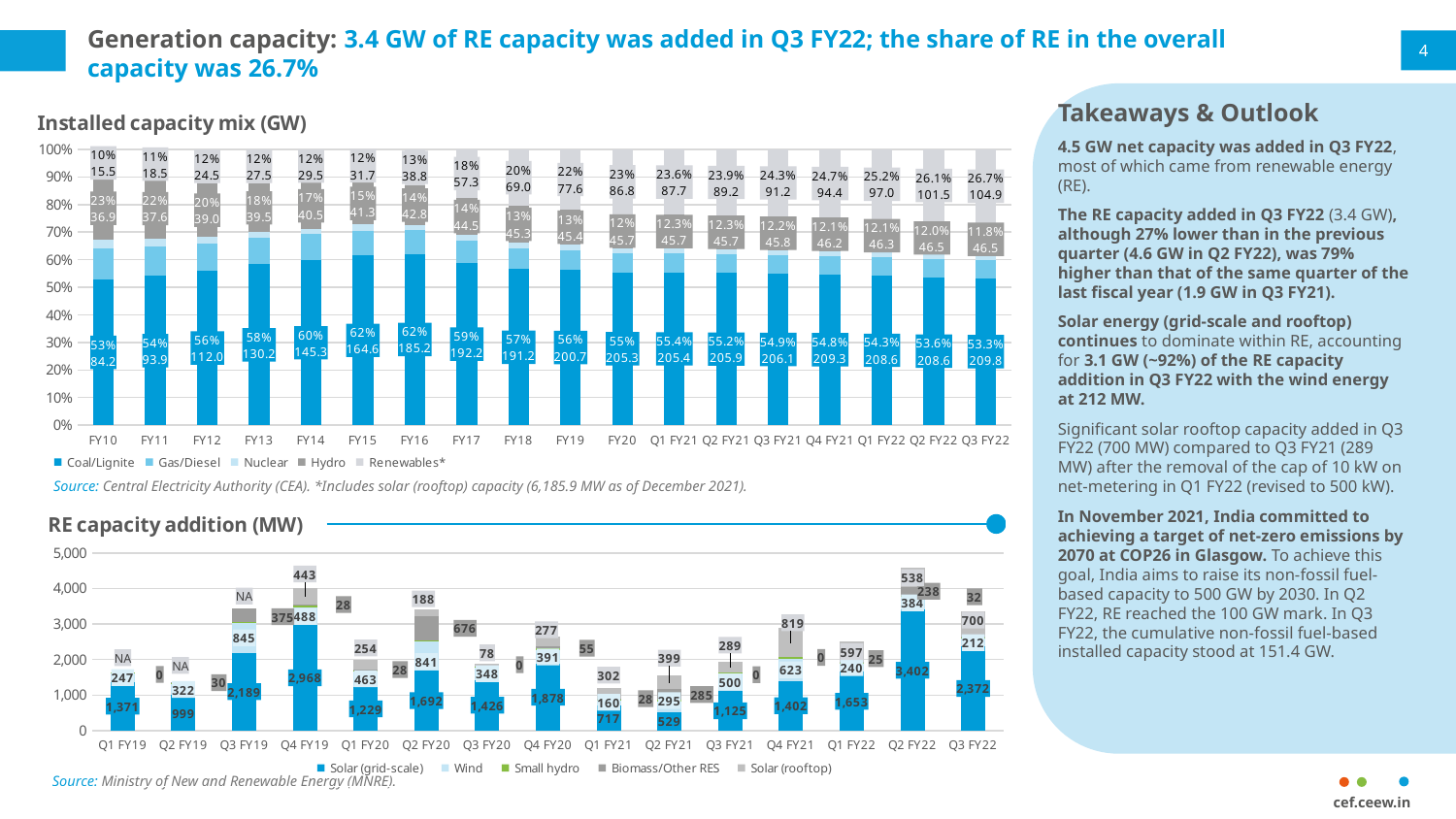
In the 'Installed capacity mix (GW)' chart, how many series does the legend list? 5 In the 'RE capacity addition (MW)' chart, what is the Solar (grid-scale) capacity added in Q2 FY22? 3,402 In the 'RE capacity addition (MW)' chart, what is the difference between the Solar (grid-scale) additions in Q2 FY22 and Q3 FY22? 1,030 In the 'RE capacity addition (MW)' chart, what is the Solar (rooftop) capacity added in Q3 FY22? 700 In the 'Installed capacity mix (GW)' chart, what is the Coal/Lignite capacity in GW for FY16? 185.2 In the 'RE capacity addition (MW)' chart, how many quarters are shown on the x axis? 15 In the 'Installed capacity mix (GW)' chart, what is the Renewables share of installed capacity in Q3 FY22? 26.7% What type of chart is the 'RE capacity addition (MW)' chart? stacked bar chart In the 'Installed capacity mix (GW)' chart, which is larger: the Hydro share in FY10 or the Renewables share in FY10? Hydro share in FY10 In the 'Installed capacity mix (GW)' chart, does the Renewables share rise or fall from FY10 to Q3 FY22? rise In the 'RE capacity addition (MW)' chart, which quarter has the lowest Solar (grid-scale) addition? Q2 FY21 In the 'RE capacity addition (MW)' chart, is the total bar height for Q2 FY19 greater or less than 2,000? less